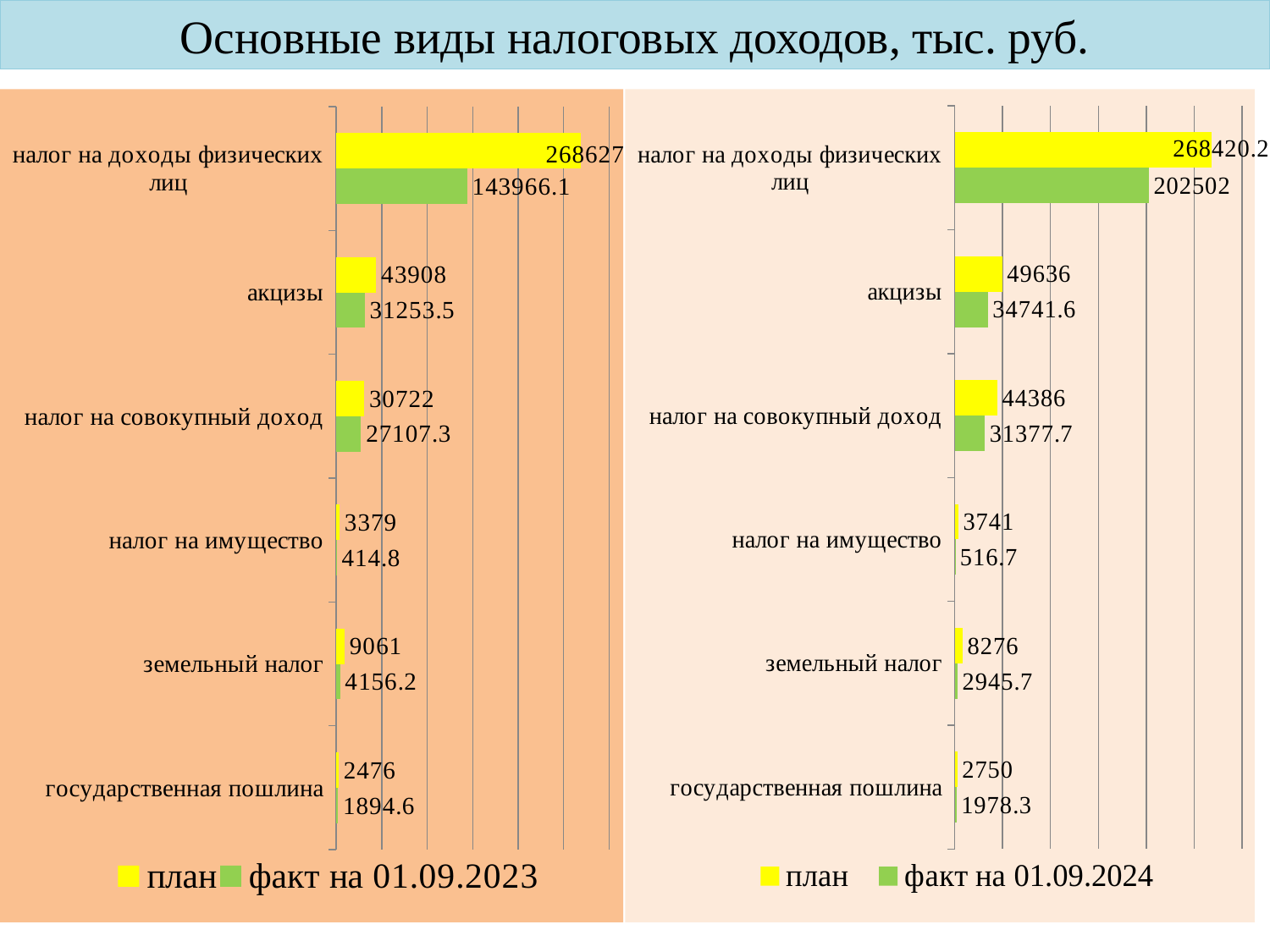
In the right chart (факт на 01.09.2024), what is the факт value for налог на доходы физических лиц? 202502 In the left chart (факт на 01.09.2023), what is the difference between the план and факт values for налог на доходы физических лиц? 124660.9 In the left chart (факт на 01.09.2023), what is the план value for налог на доходы физических лиц? 268627 In the left chart (факт на 01.09.2023), what is the факт value for акцизы? 31253.5 What type of chart is the left chart (факт на 01.09.2023)? bar chart How many series does the legend of the right chart (факт на 01.09.2024) list? 2 In the right chart (факт на 01.09.2024), which category has the highest план value? налог на доходы физических лиц In the right chart (факт на 01.09.2024), what is the difference between the план and факт values for акцизы? 14894.4 In the left chart (факт на 01.09.2023), which category has the lowest факт value? налог на имущество In the right chart (факт на 01.09.2024), what is the план value for земельный налог? 8276 How many categories are shown in the left chart (факт на 01.09.2023)? 6 In the right chart (факт на 01.09.2024), which is larger for налог на совокупный доход: план or факт? план